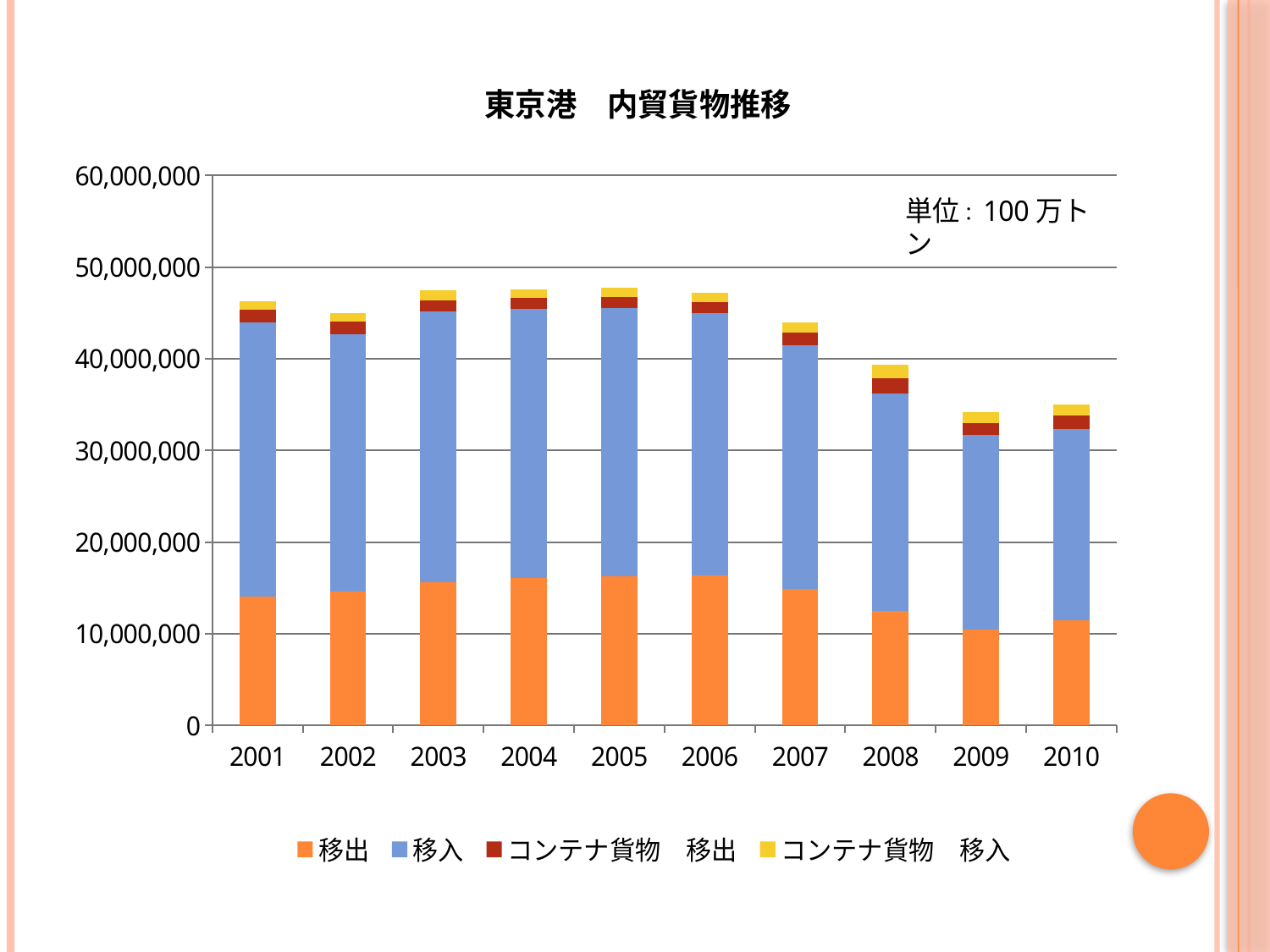
Is the total stacked bar for 2009 greater or less than 40,000,000? less How many series does the legend list? 4 Which year has the lowest total stacked bar? 2009 Do the total stacked bars rise or fall from 2006 to 2009? fall Which is larger, the total stacked bar for 2001 or for 2008? 2001 How many years are shown on the x axis of the chart? 10 Which series is shown in orange in the chart? 移出 Is the total stacked bar for 2010 greater or less than 30,000,000? greater Is the 移出 value for 2005 greater or less than 10,000,000? greater What kind of chart is shown on the slide? Stacked bar chart What is the title of the chart? 東京港 内貿貨物推移